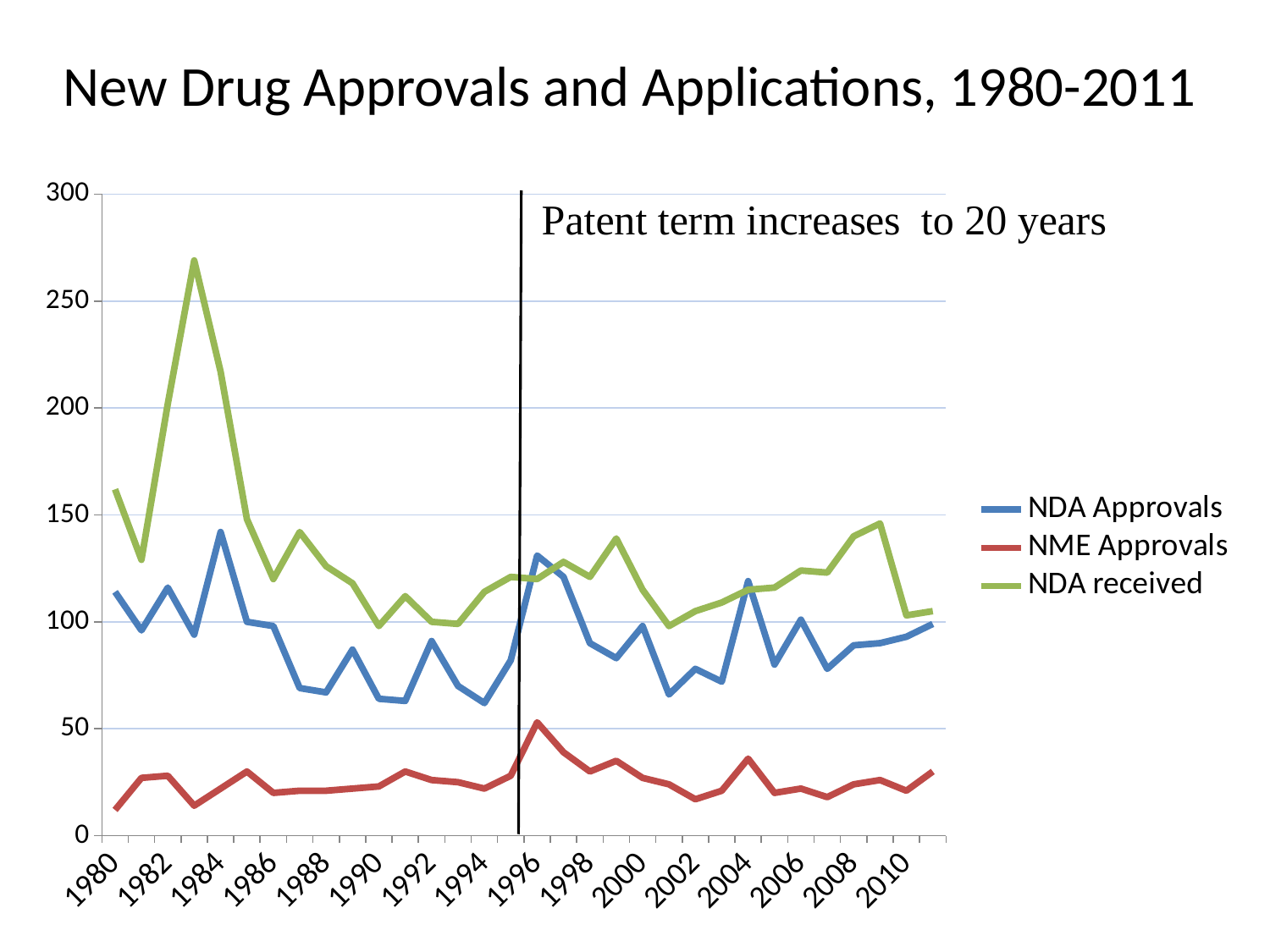
What kind of chart is shown on the slide? Line chart Is the value for NDA Approvals in 1994 greater or less than 100? less Is the value for NME Approvals in 1980 greater or less than 50? less Which series has the lowest values throughout the chart? NME Approvals How many series does the legend list? 3 What event does the vertical line annotation on the chart mark? Patent term increases to 20 years Which series reaches the highest value on the chart? NDA received Does the NDA received line rise or fall between 1984 and 1986? Fall In 1980, which is larger: NDA received or NDA Approvals? NDA received Which series is drawn in green? NDA received Is the value for NDA received in 1980 greater or less than 150? greater